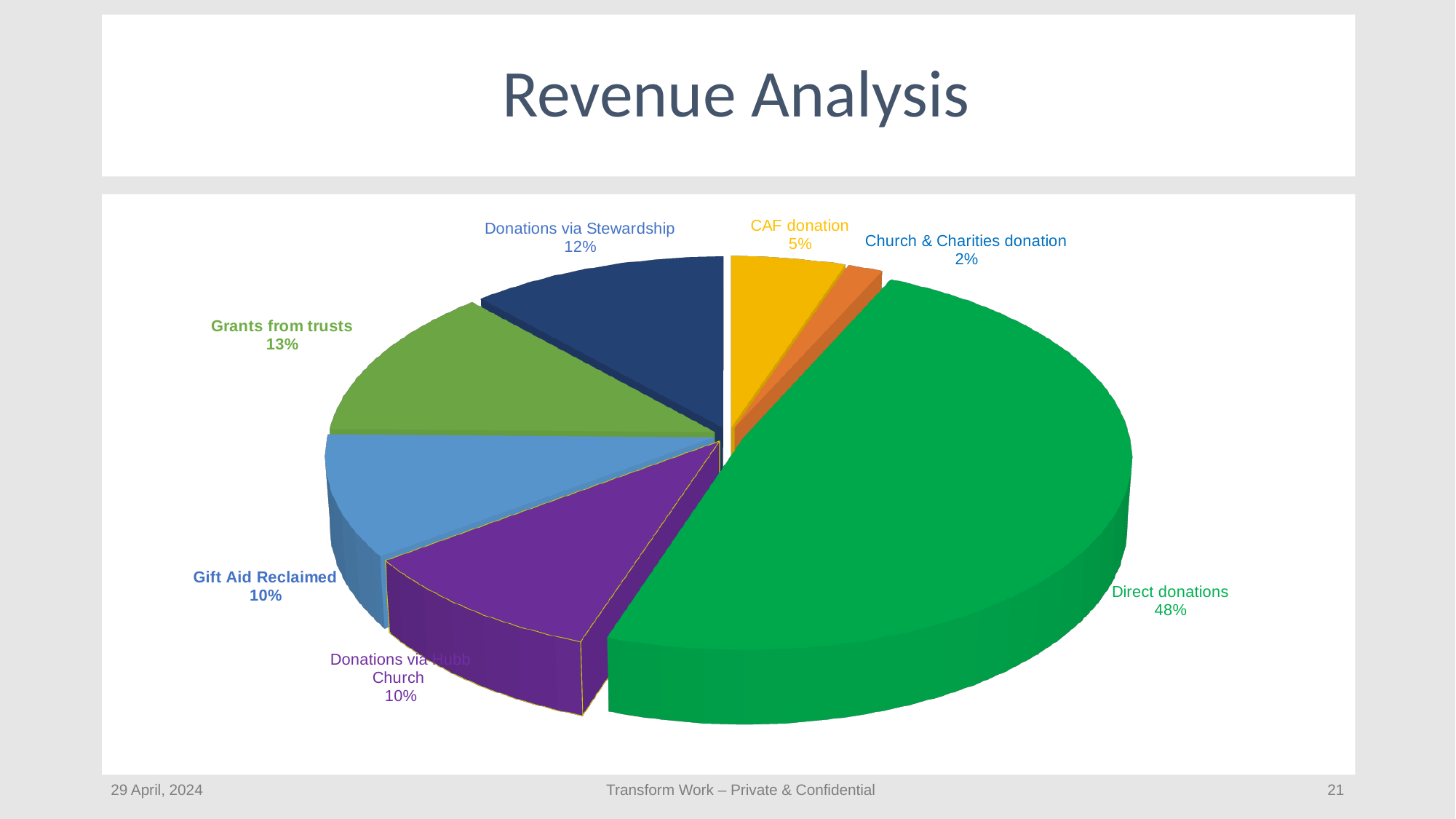
Which category has the smallest share of the pie? Church & Charities donation What kind of chart is shown on the slide? Pie chart What share of revenue comes from Direct donations? 48% What percentage is shown for Donations via Stewardship? 12% What is the difference in percentage points between Direct donations and Grants from trusts? 35 Which is larger, the share for Grants from trusts or the share for Donations via Stewardship? Grants from trusts What percentage is shown for CAF donation? 5% Which category has the largest share of the pie? Direct donations What percentage is shown for Grants from trusts? 13% What is the title of the slide containing the chart? Revenue Analysis How many categories are shown in the pie chart? 7 What colour is the Direct donations slice? Green